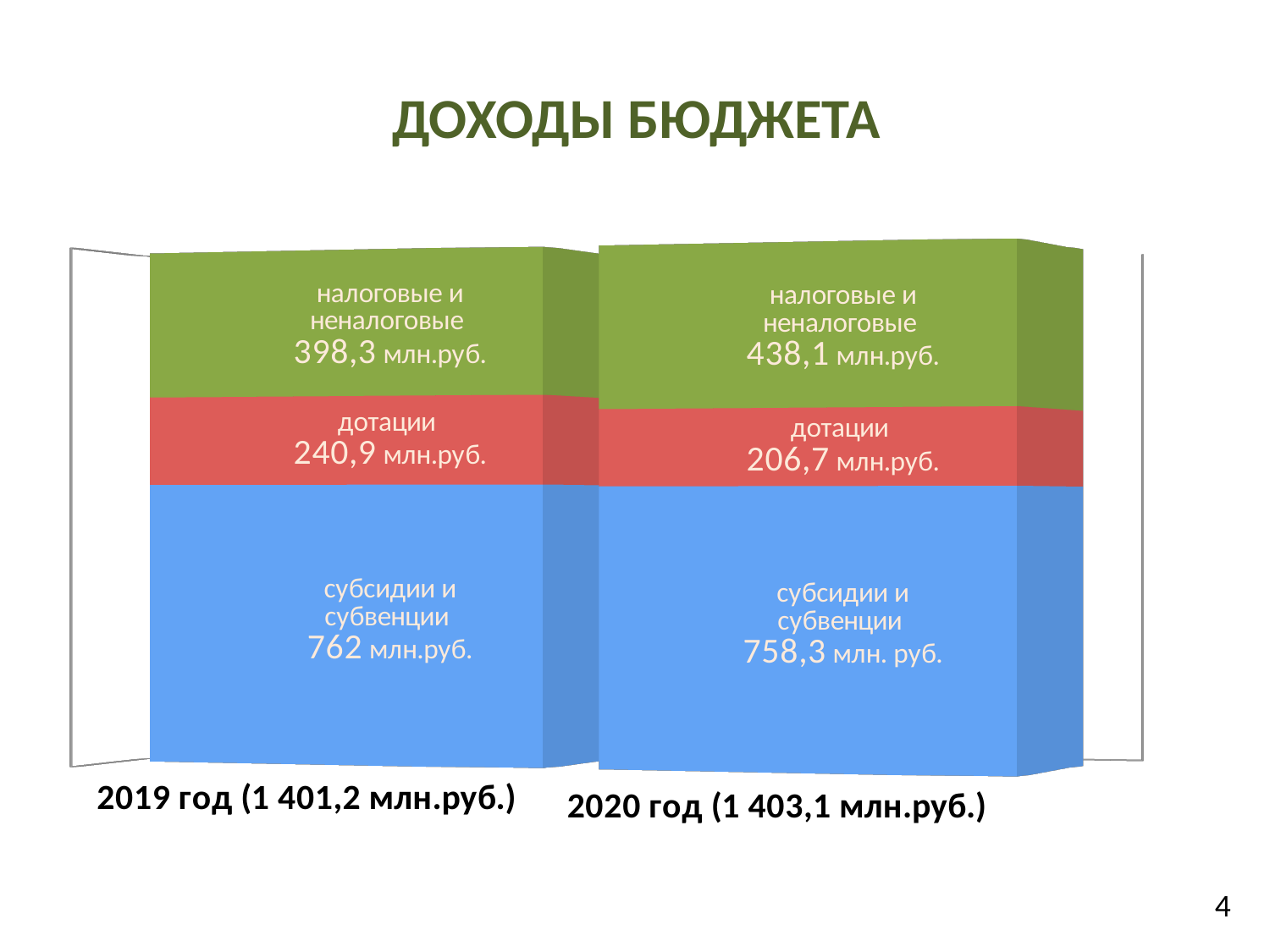
What is the difference in дотации between 2019 and 2020? 34,2 млн.руб. What kind of chart is shown on the slide? stacked bar chart Which segment is the largest in the 2019 bar? субсидии и субвенции What is the value of субсидии и субвенции for 2019? 762 млн.руб. What is the value of дотации for 2020? 206,7 млн.руб. By how much did налоговые и неналоговые increase from 2019 to 2020? 39,8 млн.руб. What is the value of налоговые и неналоговые for 2020? 438,1 млн.руб. Which year has the larger value for дотации, 2019 or 2020? 2019 Which segment is the smallest in the 2020 bar? дотации What is the value of налоговые и неналоговые for 2019? 398,3 млн.руб. How many segments does each stacked bar contain? 3 What is the total of the 2020 bar? 1 403,1 млн.руб.